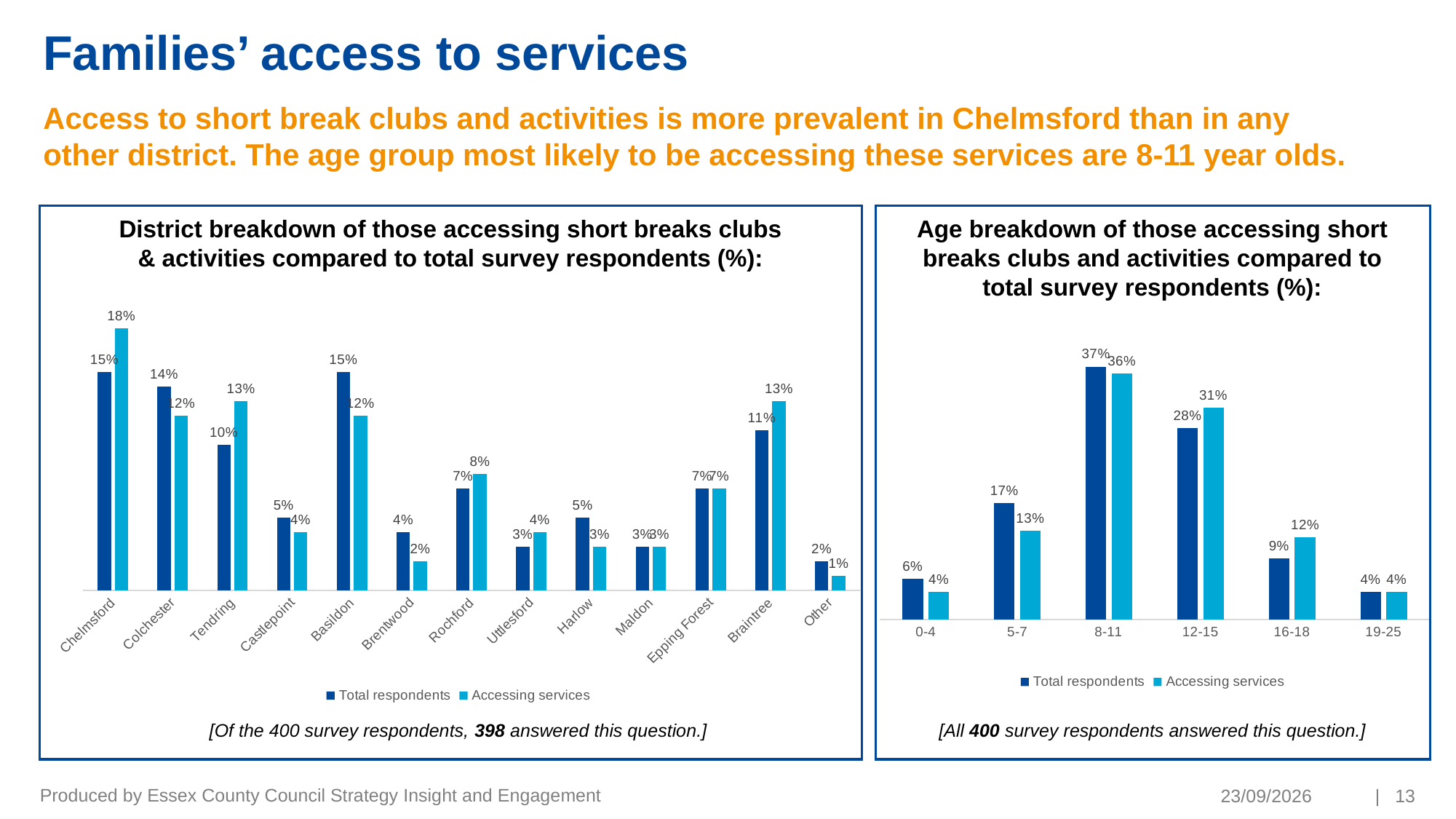
In the Age breakdown chart, which age group has the highest Total respondents value? 8-11 In the District breakdown chart, which district has the highest Accessing services value? Chelmsford In the Age breakdown chart, what is the difference between the Total respondents and Accessing services values for the 5-7 age group? 4% In the District breakdown chart, which is larger for Colchester: Total respondents or Accessing services? Total respondents In the Age breakdown chart, which age group has the lowest Accessing services value? 0-4 and 19-25 (both 4%) In the Age breakdown chart, what is the Accessing services value for the 12-15 age group? 31% In the District breakdown chart, what is the difference between the Accessing services and Total respondents values for Tendring? 3% What type of chart is the Age breakdown chart? Bar chart In the District breakdown chart, what is the Total respondents value for Braintree? 11% How many series does the legend of the Age breakdown chart list? 2 How many district categories are shown on the x axis of the District breakdown chart? 13 In the District breakdown chart, what is the Accessing services value for Chelmsford? 18%